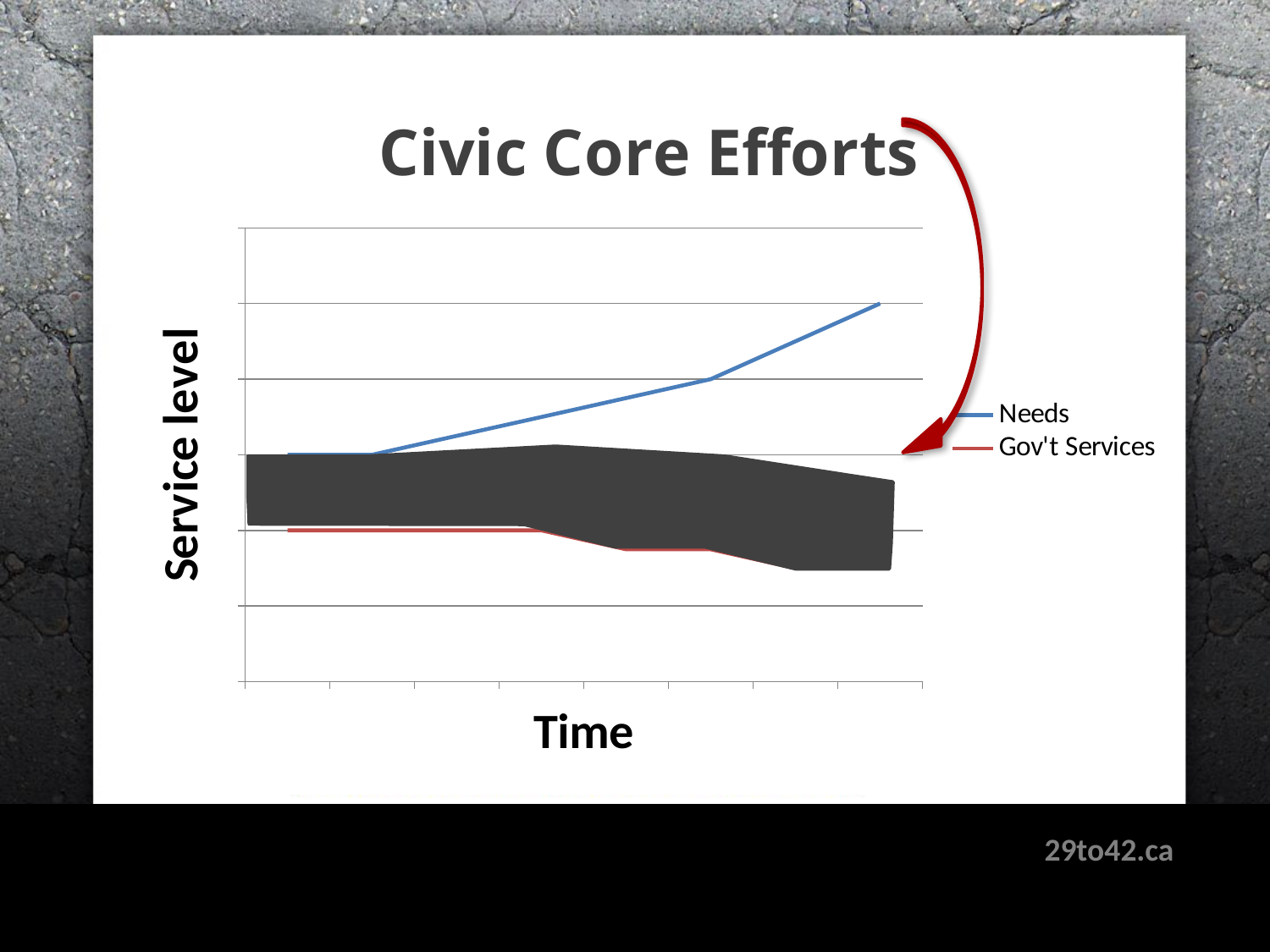
How many series does the legend list? 2 What kind of chart is shown on the slide? Line chart Does the Needs line rise or fall as time moves along the x axis? Rises Which series is plotted in red? Gov't Services Which series is plotted in blue? Needs What is the title of the chart? Civic Core Efforts Does the Gov't Services line rise or fall as time moves along the x axis? Falls Which series starts at a higher service level at the left of the chart, Needs or Gov't Services? Needs At the right end of the chart, which series has the higher service level, Needs or Gov't Services? Needs Does the gap between the Needs line and the Gov't Services line widen or narrow over time? Widens